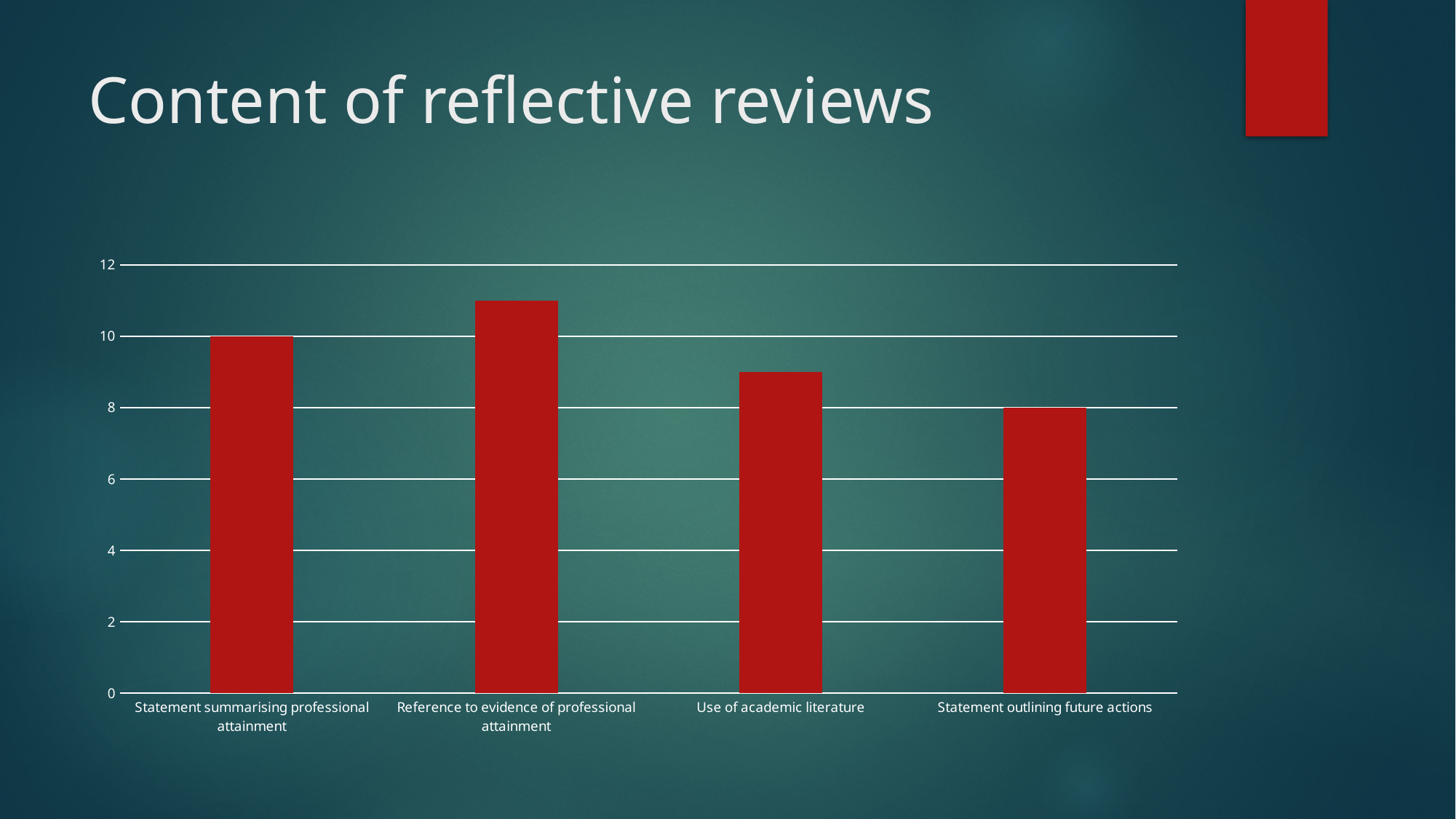
Which category has the highest value? Reference to evidence of professional attainment How many categories are shown on the x axis? 4 Is the value for Reference to evidence of professional attainment greater or less than 10? greater What is the value for Statement summarising professional attainment? 10 Which is larger: the value for Statement summarising professional attainment or the value for Use of academic literature? Statement summarising professional attainment What is the difference between the values for Statement summarising professional attainment and Statement outlining future actions? 2 Which category has the lowest value? Statement outlining future actions What is the title of the slide containing the chart? Content of reflective reviews Is the value for Use of academic literature greater or less than 10? less What kind of chart is shown on the slide? bar chart Is the value for Use of academic literature greater or less than 8? greater What is the value for Statement outlining future actions? 8